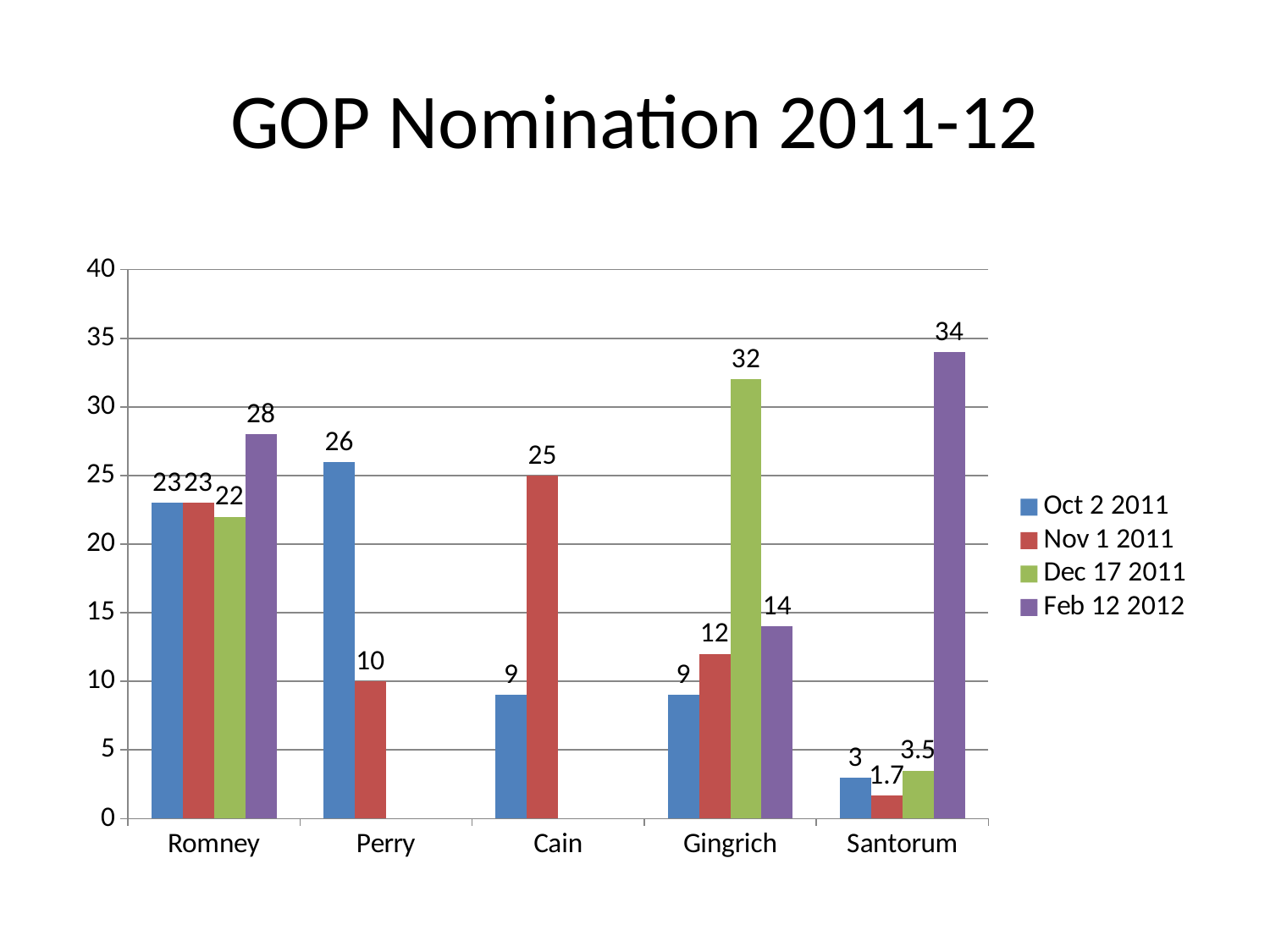
How many candidates are shown on the x axis? 5 What is the value for Santorum in the Nov 1 2011 series? 1.7 Which is larger: Cain's Nov 1 2011 value or Perry's Oct 2 2011 value? Perry's Oct 2 2011 value What is the difference between Perry's Oct 2 2011 value and his Nov 1 2011 value? 16 What is the title of the chart? GOP Nomination 2011-12 Which candidate has the highest value in the Feb 12 2012 series? Santorum What is the value for Romney in the Feb 12 2012 series? 28 How many series does the legend list? 4 What is the value for Gingrich in the Dec 17 2011 series? 32 Which candidate has the lowest value in the Oct 2 2011 series? Santorum Do Santorum's values rise or fall from Oct 2 2011 to Feb 12 2012? Rise What kind of chart is shown on the slide? Bar chart